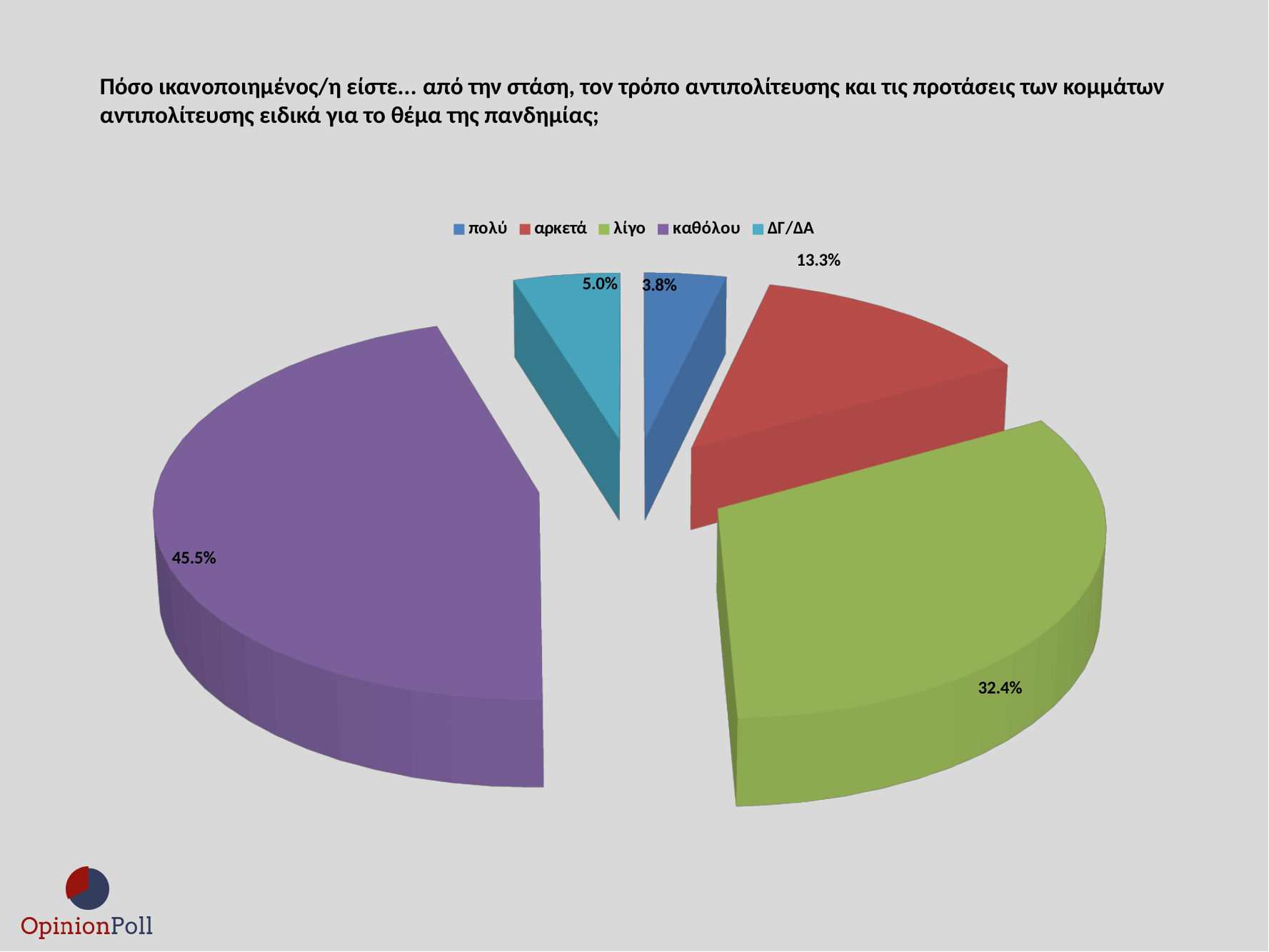
Which is larger, the share for "αρκετά" or the share for "ΔΓ/ΔΑ"? αρκετά How many categories does the legend list? 5 What percentage of respondents answered "ΔΓ/ΔΑ"? 5.0% What kind of chart is shown on the slide? Pie chart Which response has the largest share of the pie? καθόλου Which response has the smallest share of the pie? πολύ What is the difference in percentage points between "καθόλου" and "λίγο"? 13.1 What percentage of respondents answered "πολύ"? 3.8% What colour is the slice for "λίγο"? Green What percentage of respondents answered "καθόλου"? 45.5% What percentage of respondents answered "αρκετά"? 13.3% What percentage of respondents answered "λίγο"? 32.4%